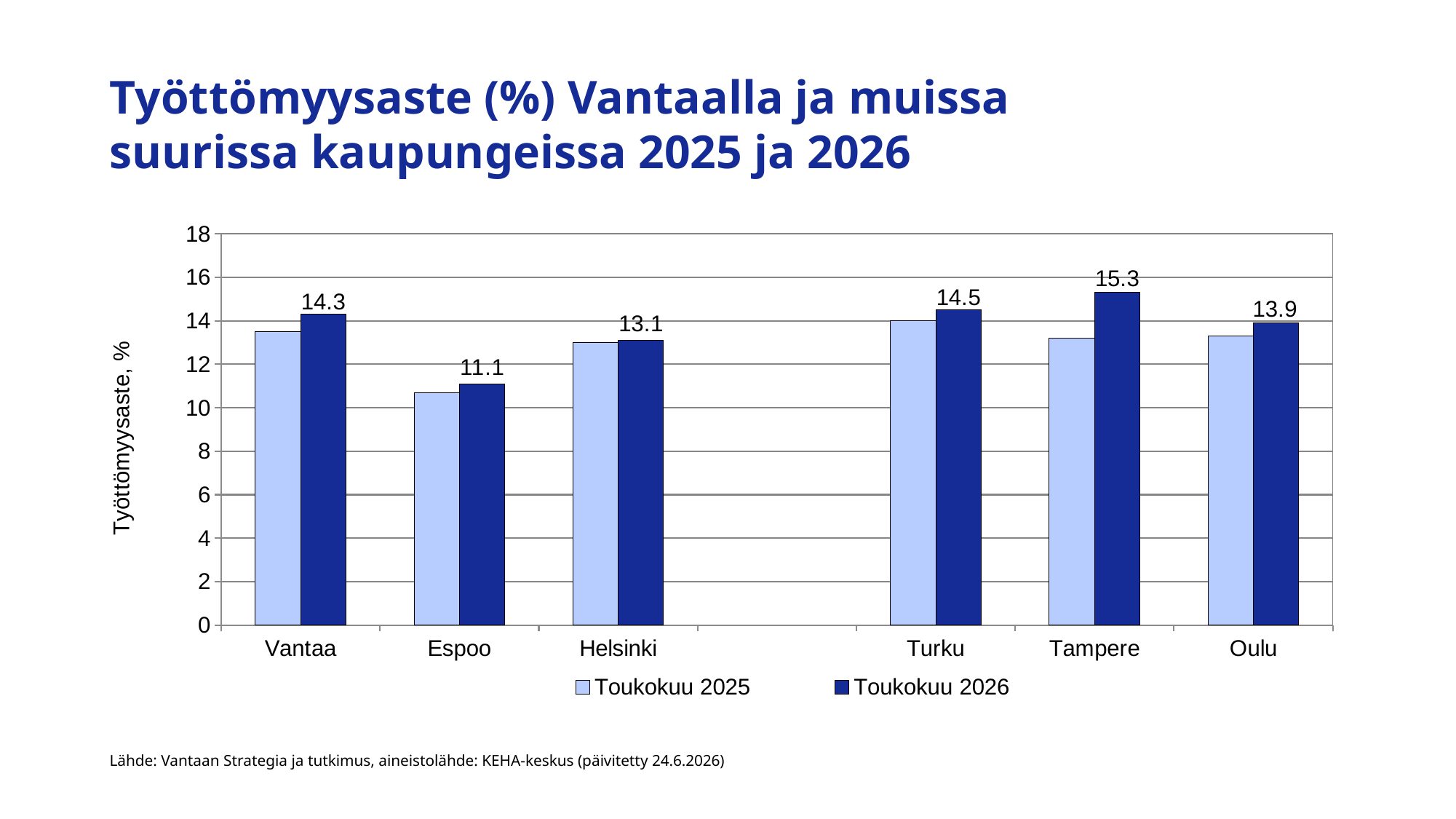
How many cities are shown on the x axis of the chart? 6 What is the unemployment rate for Espoo in Toukokuu 2026? 11.1 How many series does the legend list? 2 What is the difference between the Toukokuu 2026 unemployment rates of Tampere and Espoo? 4.2 What is the unemployment rate for Oulu in Toukokuu 2026? 13.9 What kind of chart is shown on the slide? bar chart Which is larger in Toukokuu 2026: the unemployment rate of Turku or of Vantaa? Turku Is the Toukokuu 2025 unemployment rate for Espoo greater or less than 12? less What is the difference between the Toukokuu 2026 unemployment rates of Turku and Helsinki? 1.4 What is the unemployment rate for Tampere in Toukokuu 2026? 15.3 Which city has the lowest unemployment rate in Toukokuu 2026? Espoo Which city has the highest unemployment rate in Toukokuu 2026? Tampere